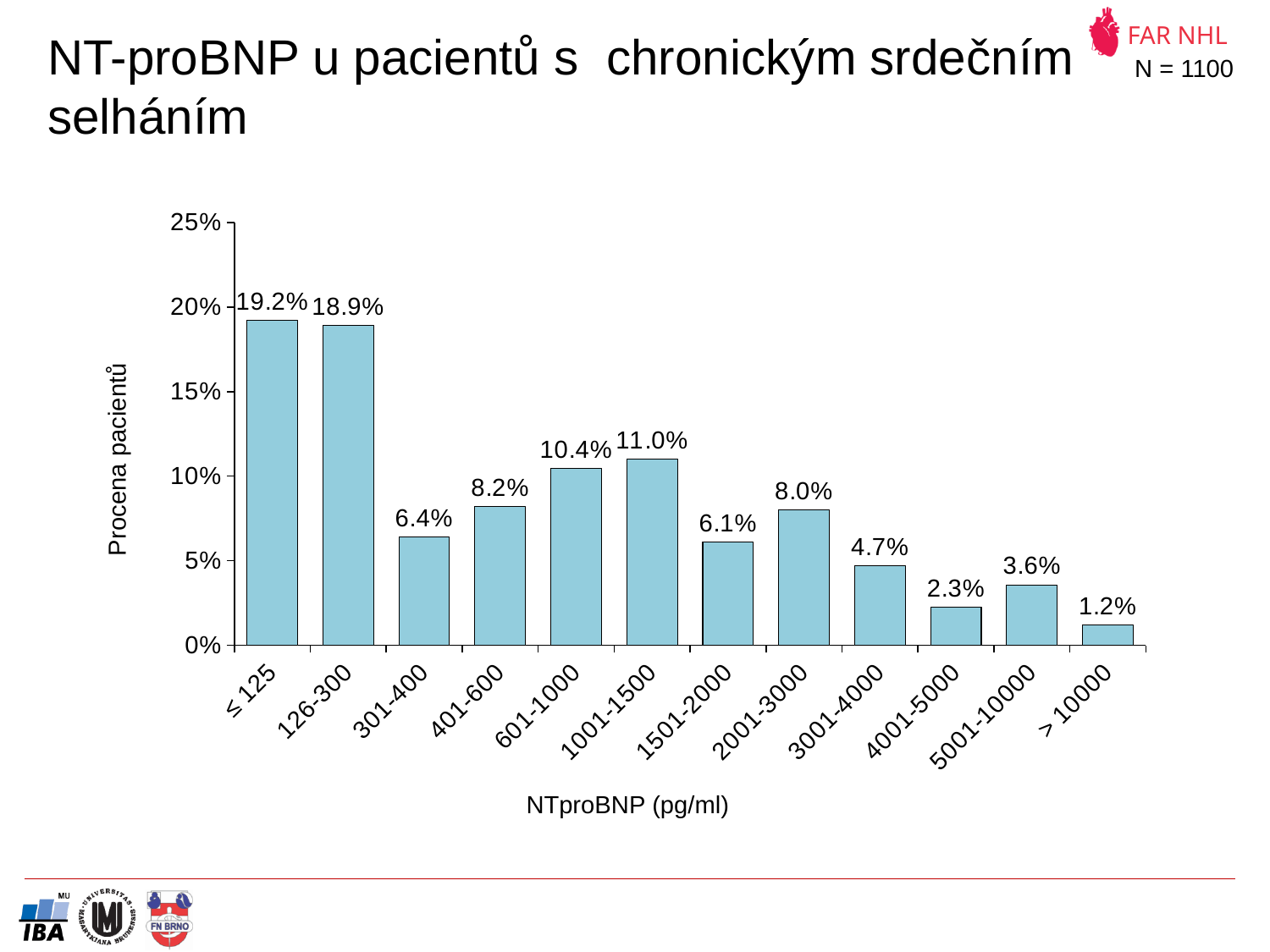
Which is larger, the value for 401-600 or the value for 2001-3000? 401-600 What is the value for the > 10000 pg/ml category? 1.2% What is the label of the x axis? NTproBNP (pg/ml) What is the value for the 1001-1500 pg/ml category? 11.0% What kind of chart is shown on the slide? bar chart What is the difference between the values for 601-1000 and 1501-2000? 4.3% Is the value for 301-400 greater or less than 5%? greater How many NT-proBNP categories are shown on the x axis? 12 Which NT-proBNP category has the lowest percentage of patients? > 10000 Which NT-proBNP category has the highest percentage of patients? ≤ 125 What is the difference between the values for ≤ 125 and 126-300? 0.3% What percentage of patients have NT-proBNP of 126-300 pg/ml? 18.9%